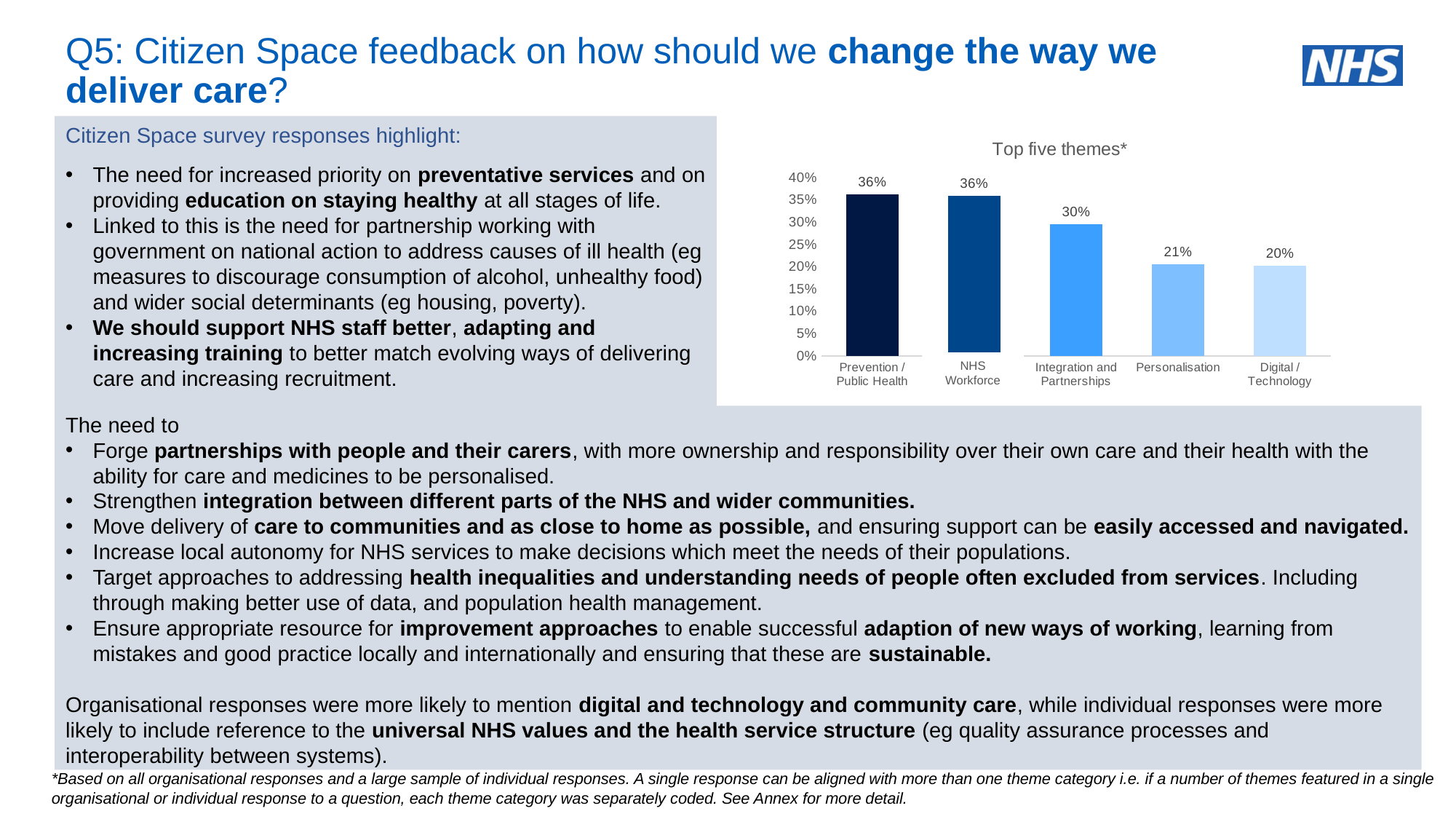
Which theme has the lowest value? Digital / Technology Which is larger, the value for Integration and Partnerships or the value for Personalisation? Integration and Partnerships What is the difference between the values for Integration and Partnerships and Personalisation? 9% How many themes are shown in the chart? 5 What is the value for Integration and Partnerships? 30% What is the difference between the values for Prevention / Public Health and Integration and Partnerships? 6% What is the title of the chart? Top five themes* What is the value for NHS Workforce? 36% What is the value for Personalisation? 21% What is the value for Digital / Technology? 20% What kind of chart is shown on the slide? bar chart Is the value for Personalisation greater or less than 25%? less